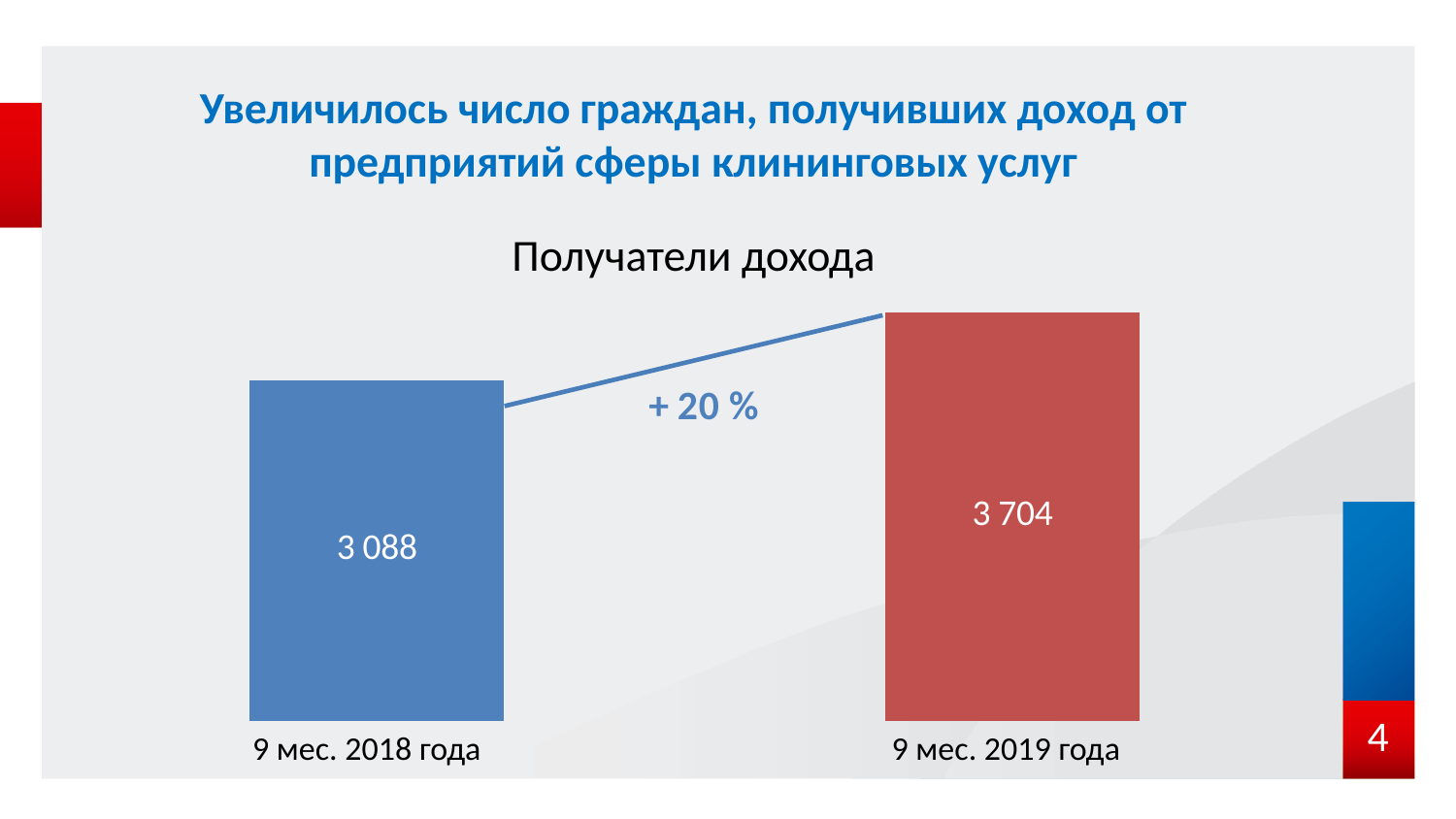
How many categories are shown in the chart? 2 Which is larger, the value for 9 мес. 2018 года or 9 мес. 2019 года? 9 мес. 2019 года What is the difference between the values for 9 мес. 2019 года and 9 мес. 2018 года? 616 What percentage change is annotated between the two bars? + 20 % Which category has the highest value? 9 мес. 2019 года What is the value for 9 мес. 2019 года? 3 704 What is the value for 9 мес. 2018 года? 3 088 Do the values rise or fall from 9 мес. 2018 года to 9 мес. 2019 года? rise Which category has the lowest value? 9 мес. 2018 года What is the title of the chart? Получатели дохода What kind of chart is shown on the slide? bar chart